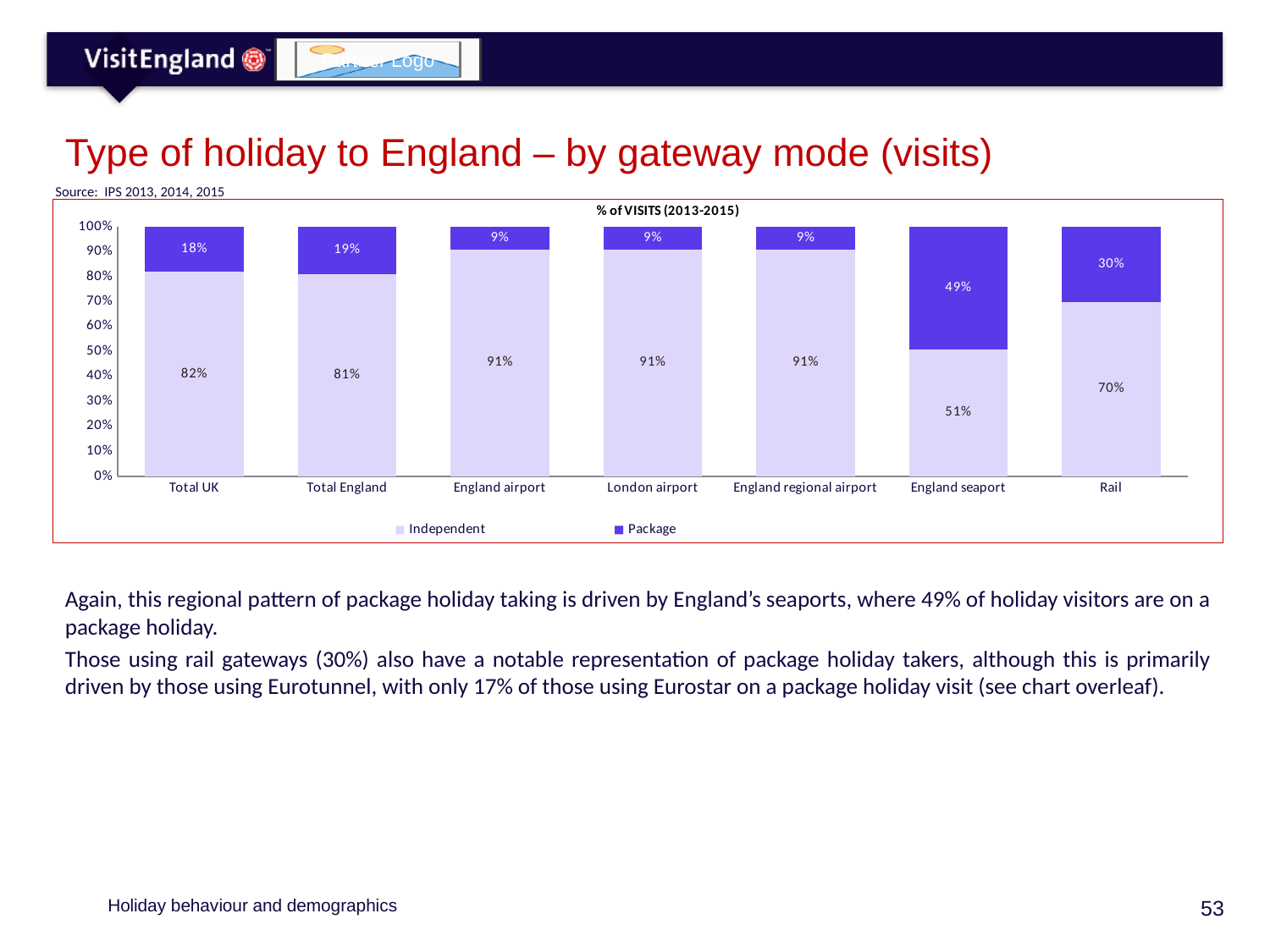
Which gateway mode has the lowest Independent share? England seaport What is the Package share for Total England? 19% What kind of chart is shown on the slide? Stacked bar chart What is the title shown above the chart? % of VISITS (2013-2015) What is the Package share for England seaport? 49% Which gateway mode has the highest Package share? England seaport What is the difference between the Package share for Rail and the Package share for London airport? 21% How many series does the legend list? 2 What is the Independent share for Rail? 70% Which is larger, the Independent share for Total UK or the Independent share for Total England? Total UK How many gateway mode categories are shown on the x axis? 7 What is the Independent share for Total UK? 82%